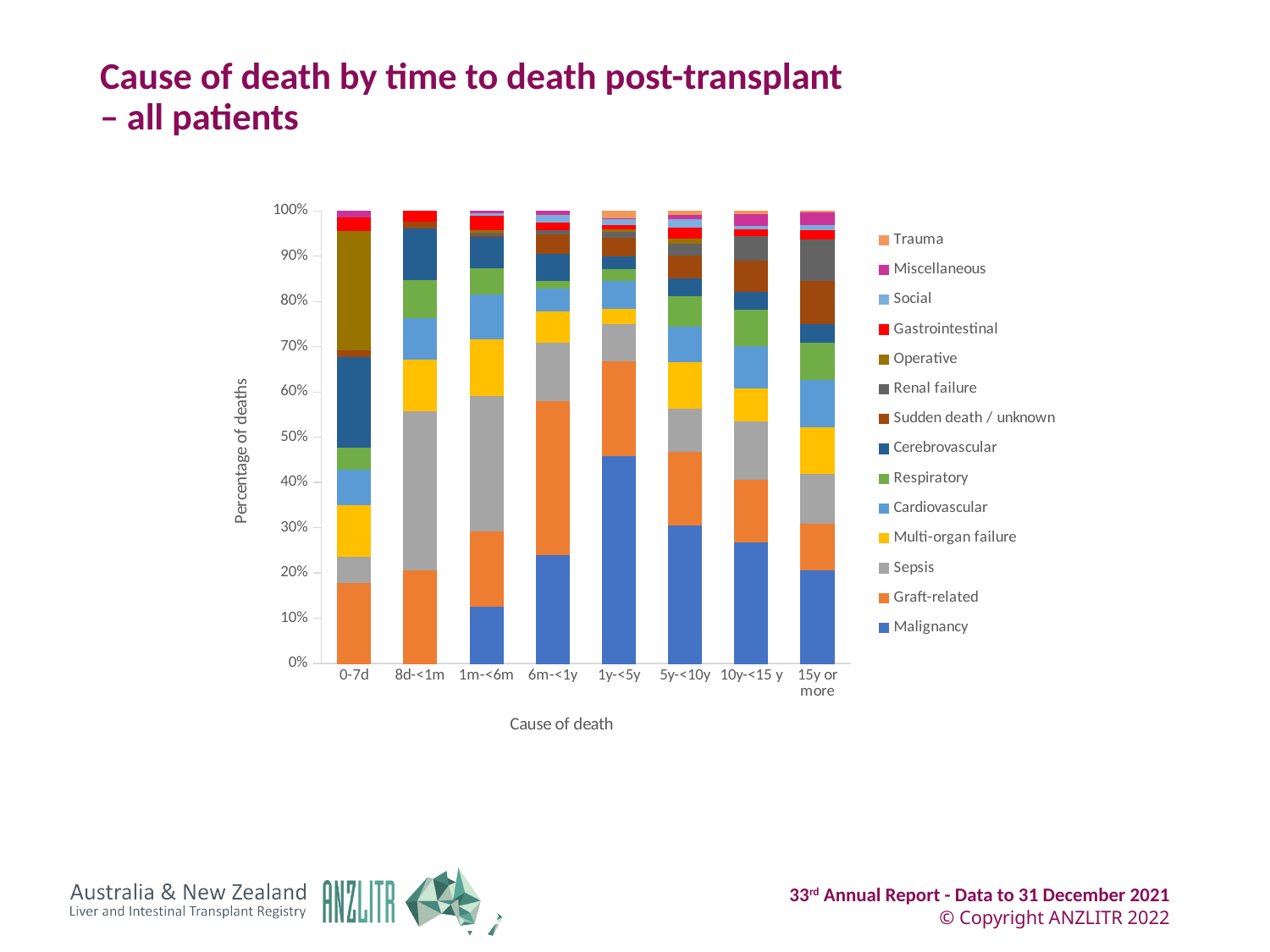
Which time category has the largest Operative share? 0-7d Is the Malignancy share for the 1y-<5y bar greater or less than 40%? greater What kind of chart is shown on the slide? Stacked bar chart How many time-to-death categories are shown on the x axis? 8 Which time category has the largest Malignancy share? 1y-<5y Is the Operative share for the 0-7d bar greater or less than 20%? greater What is the title of the chart? Cause of death by time to death post-transplant – all patients How many causes of death does the legend list? 14 What is the label on the vertical axis? Percentage of deaths Is the Malignancy share for the 1m-<6m bar greater or less than 20%? less Which bar has the larger Malignancy share, 1y-<5y or 15y or more? 1y-<5y From 1y-<5y to 15y or more, does the Malignancy share rise or fall? fall